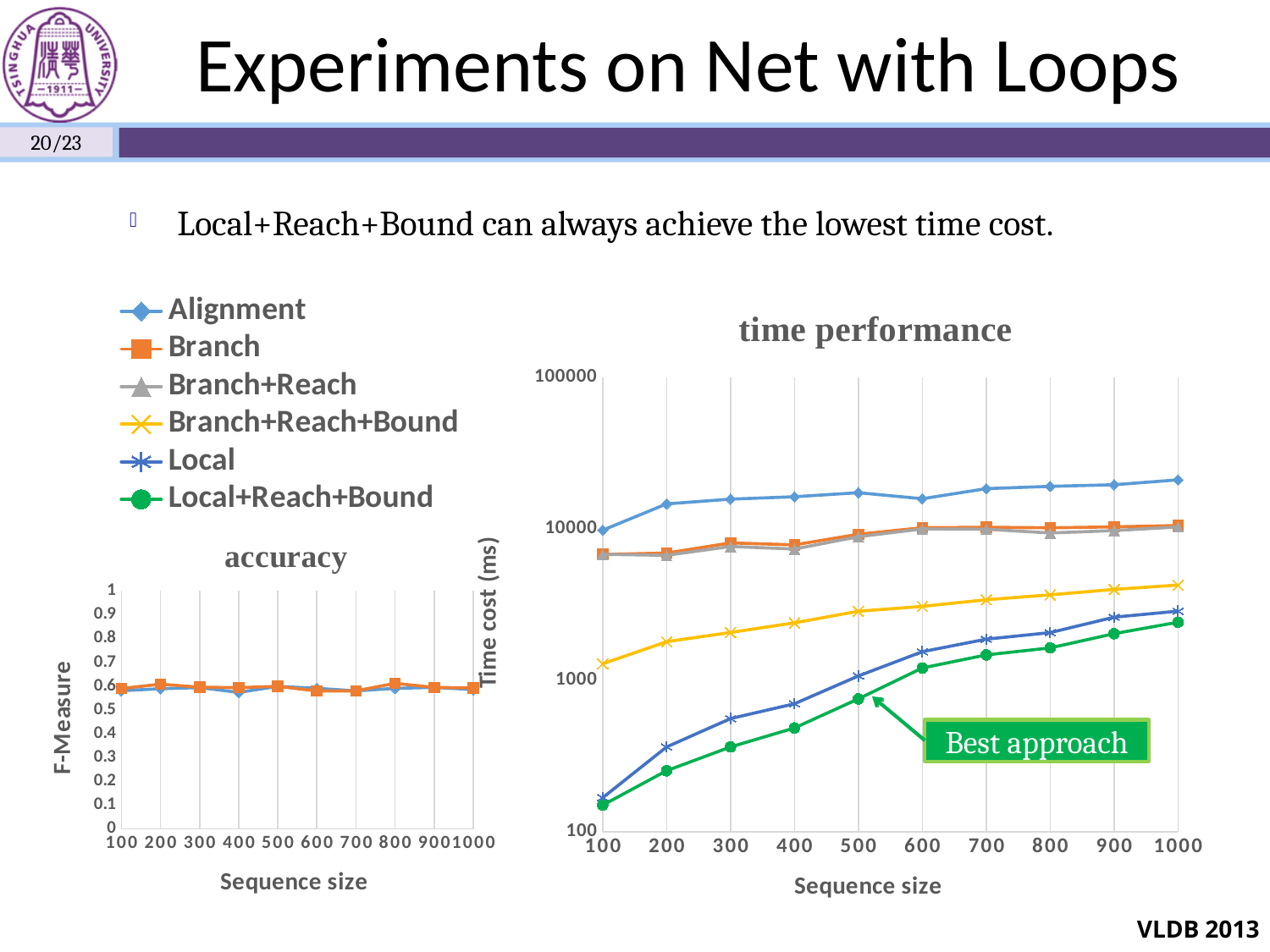
How many series does the legend list for the charts on the slide? 6 What kind of chart is the 'time performance' chart on the right of the slide? line chart What is the y-axis label of the 'accuracy' chart? F-Measure In the 'time performance' chart, which series has the highest time cost at sequence size 1000? Alignment In the 'time performance' chart, is the time cost for Branch+Reach+Bound at sequence size 1000 greater or less than 10000? less In the 'time performance' chart, how many sequence size points are plotted along the x axis? 10 In the 'time performance' chart, is the time cost for Alignment at sequence size 1000 greater or less than 10000? greater In the 'accuracy' chart, is the F-Measure for Branch at sequence size 100 greater or less than 0.5? greater In the 'time performance' chart, does the time cost for Local+Reach+Bound rise or fall as sequence size increases? rises In the 'time performance' chart, which series has the lowest time cost at sequence size 1000? Local+Reach+Bound In the 'time performance' chart, at sequence size 500, which has the higher time cost: Local or Local+Reach+Bound? Local